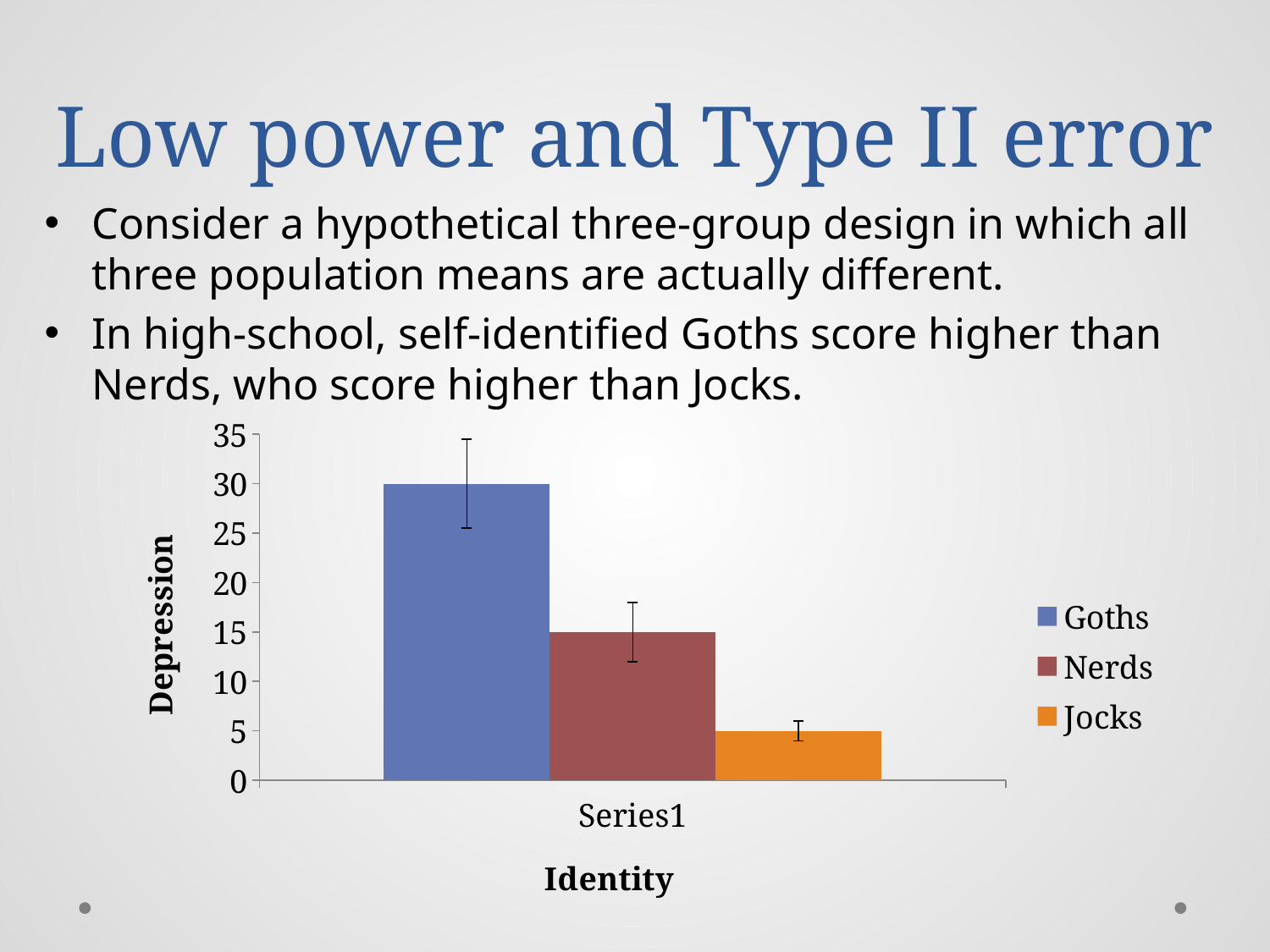
What type of chart is shown on the slide? bar chart Which group has the highest Depression value? Goths Which group has the lowest Depression value? Jocks Which is larger, the Depression value for Nerds or for Jocks? Nerds What is the Depression value for Jocks? 5 What is the Depression value for Goths? 30 What is the label on the x axis? Identity How many series does the legend list? 3 What is the difference between the Depression values for Goths and Nerds? 15 What is the Depression value for Nerds? 15 What is the label on the y axis? Depression Is the Depression value for Goths greater or less than 25? greater